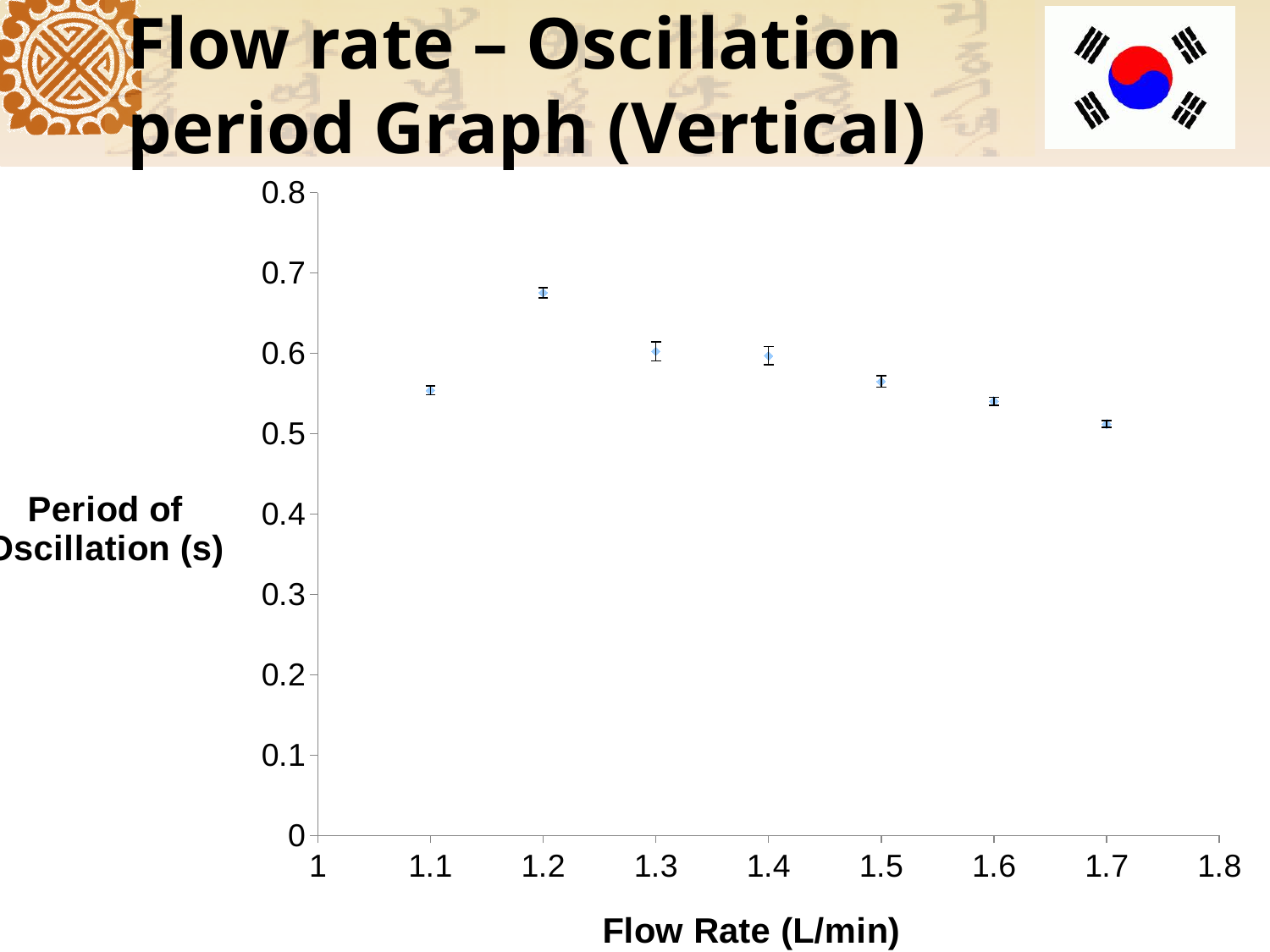
Which has a larger period of oscillation: flow rate 1.2 or flow rate 1.7? 1.2 At which flow rate is the period of oscillation lowest? 1.7 At which flow rate is the period of oscillation highest? 1.2 Which has a larger period of oscillation: flow rate 1.1 or flow rate 1.2? 1.2 From a flow rate of 1.3 to 1.7, does the period of oscillation rise or fall? fall Is the period of oscillation at a flow rate of 1.2 greater or less than 0.6? greater Is the period of oscillation at a flow rate of 1.1 greater or less than 0.6? less Is the period of oscillation at a flow rate of 1.5 greater or less than 0.6? less How many data points are plotted on the chart? 7 What kind of chart is shown on the slide? scatter chart What is the title of the x axis? Flow Rate (L/min)